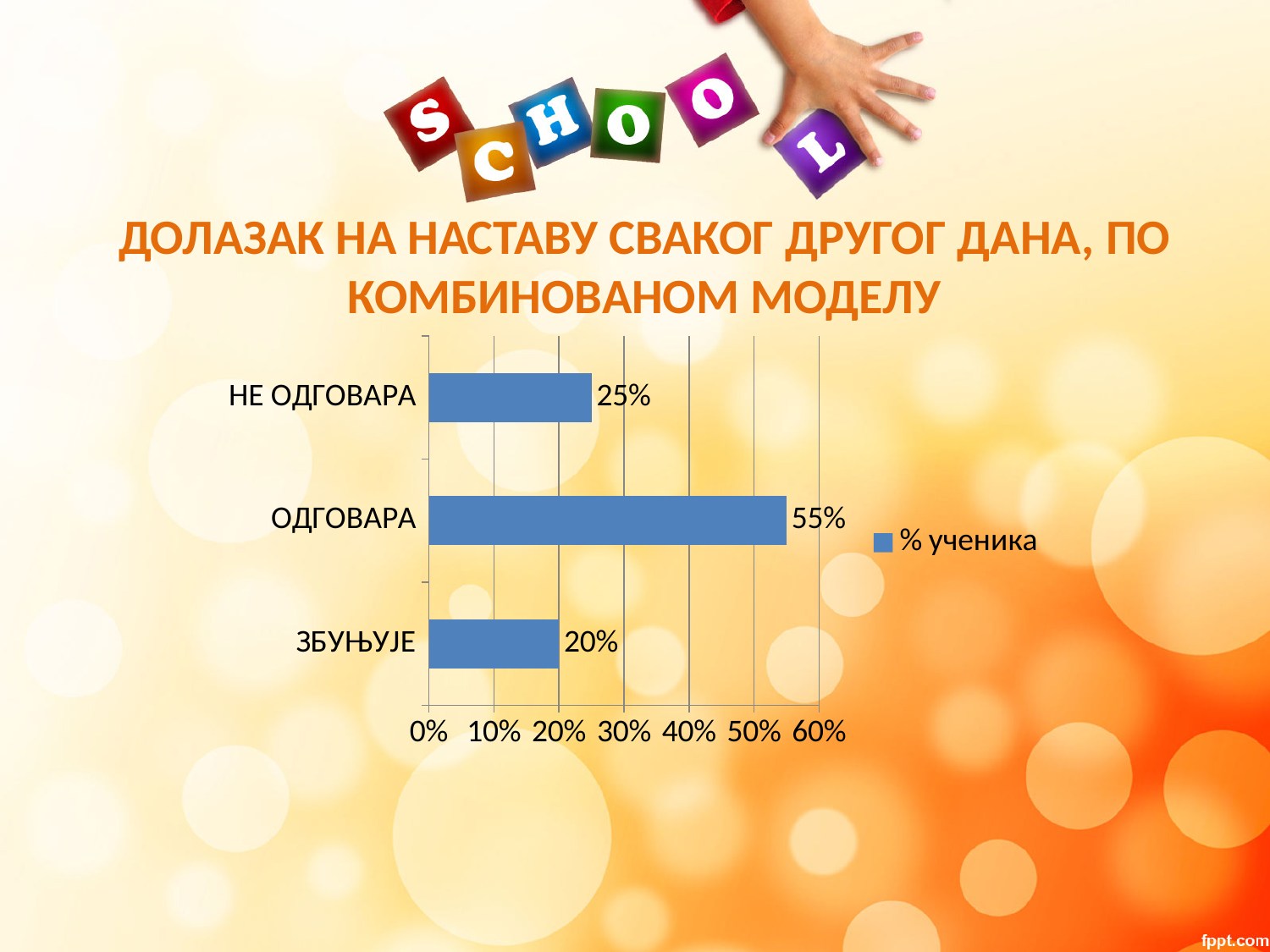
What is the difference between the values for ОДГОВАРА and НЕ ОДГОВАРА? 30% What is the value for НЕ ОДГОВАРА? 25% What kind of chart is shown on the slide? bar chart Which category has the highest value? ОДГОВАРА Which category has the lowest value? ЗБУЊУЈЕ What is the difference between the values for НЕ ОДГОВАРА and ЗБУЊУЈЕ? 5% Which is larger, the value for НЕ ОДГОВАРА or the value for ЗБУЊУЈЕ? НЕ ОДГОВАРА Is the value for ОДГОВАРА greater or less than 50%? greater What is the value for ОДГОВАРА? 55% What is the value for ЗБУЊУЈЕ? 20% How many categories are shown in the chart? 3 What series name does the legend show? % ученика